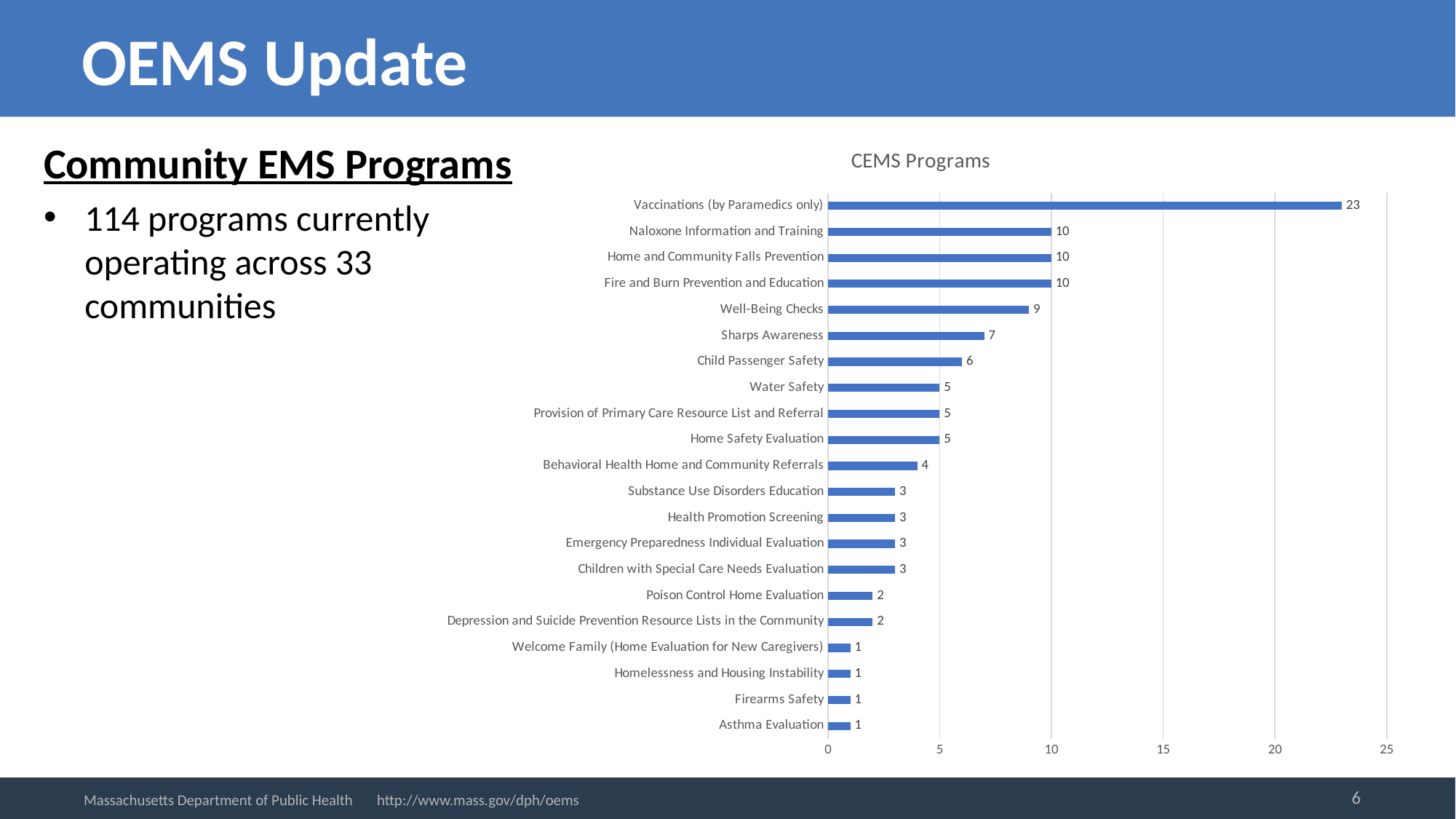
Is the value for Vaccinations (by Paramedics only) greater or less than 20? greater What is the value for Sharps Awareness in the CEMS Programs chart? 7 What is the value for Behavioral Health Home and Community Referrals in the CEMS Programs chart? 4 What is the difference between the values for Child Passenger Safety and Poison Control Home Evaluation? 4 What is the difference between the values for Vaccinations (by Paramedics only) and Naloxone Information and Training? 13 What is the value for Well-Being Checks in the CEMS Programs chart? 9 What kind of chart is the CEMS Programs chart? bar chart How many categories are shown in the CEMS Programs chart? 21 What is the value for Vaccinations (by Paramedics only) in the CEMS Programs chart? 23 Which category has the highest value in the CEMS Programs chart? Vaccinations (by Paramedics only) Which is larger, the value for Water Safety or the value for Substance Use Disorders Education? Water Safety What is the title of the chart on the slide? CEMS Programs